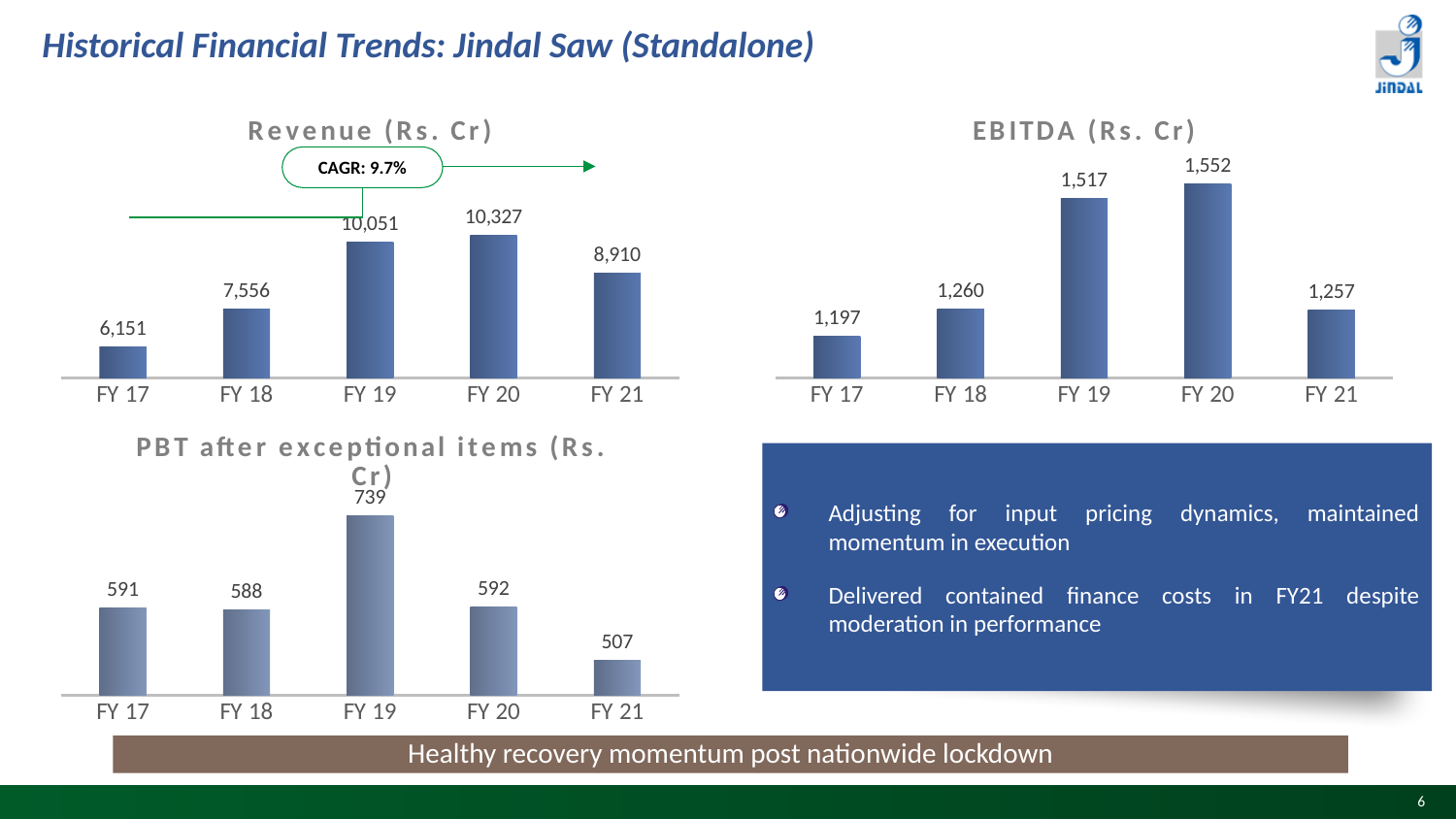
In the EBITDA (Rs. Cr) chart, what is the value for FY 19? 1,517 How many fiscal years are shown in the PBT after exceptional items (Rs. Cr) chart? 5 In the PBT after exceptional items (Rs. Cr) chart, what is the value for FY 21? 507 In the EBITDA (Rs. Cr) chart, what is the difference between FY 20 and FY 17? 355 In the Revenue (Rs. Cr) chart, what is the value for FY 20? 10,327 In the Revenue (Rs. Cr) chart, what CAGR is shown in the callout? 9.7% In the EBITDA (Rs. Cr) chart, which fiscal year has the highest EBITDA? FY 20 What type of chart is the Revenue (Rs. Cr) chart? Bar chart In the Revenue (Rs. Cr) chart, what is the difference between FY 20 and FY 21 revenue? 1,417 In the PBT after exceptional items (Rs. Cr) chart, which fiscal year has the highest value? FY 19 In the EBITDA (Rs. Cr) chart, is the value for FY 18 larger or smaller than the value for FY 21? larger In the Revenue (Rs. Cr) chart, which fiscal year has the lowest revenue? FY 17